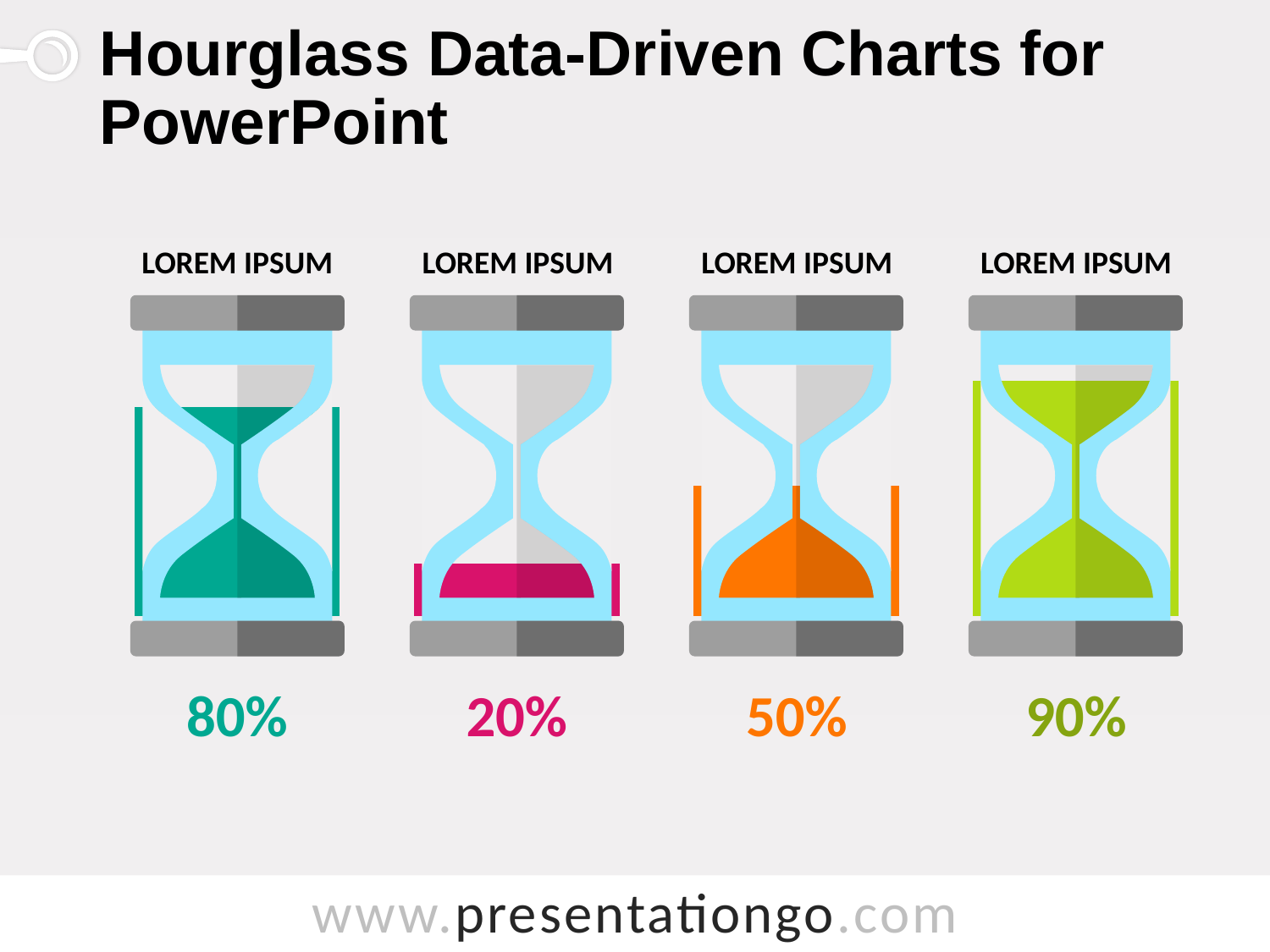
What colour is the fill of the hourglass showing 50%? Orange What is the title of the slide? Hourglass Data-Driven Charts for PowerPoint Which hourglass shows the highest percentage? The fourth (green) hourglass, 90% What percentage is shown below the third (orange) hourglass? 50% What percentage is shown below the second (pink) hourglass? 20% What percentage is shown below the first (leftmost, teal) hourglass? 80% What percentage is shown below the fourth (rightmost, green) hourglass? 90% Which hourglass shows the lowest percentage? The second (pink) hourglass, 20% Which is larger, the percentage of the first (teal) hourglass or the third (orange) hourglass? The first (teal) hourglass, 80% What is the difference between the percentages of the first (teal) and second (pink) hourglasses? 60% How many hourglass charts are shown on the slide? 4 What is the difference between the percentages of the fourth (green) and third (orange) hourglasses? 40%